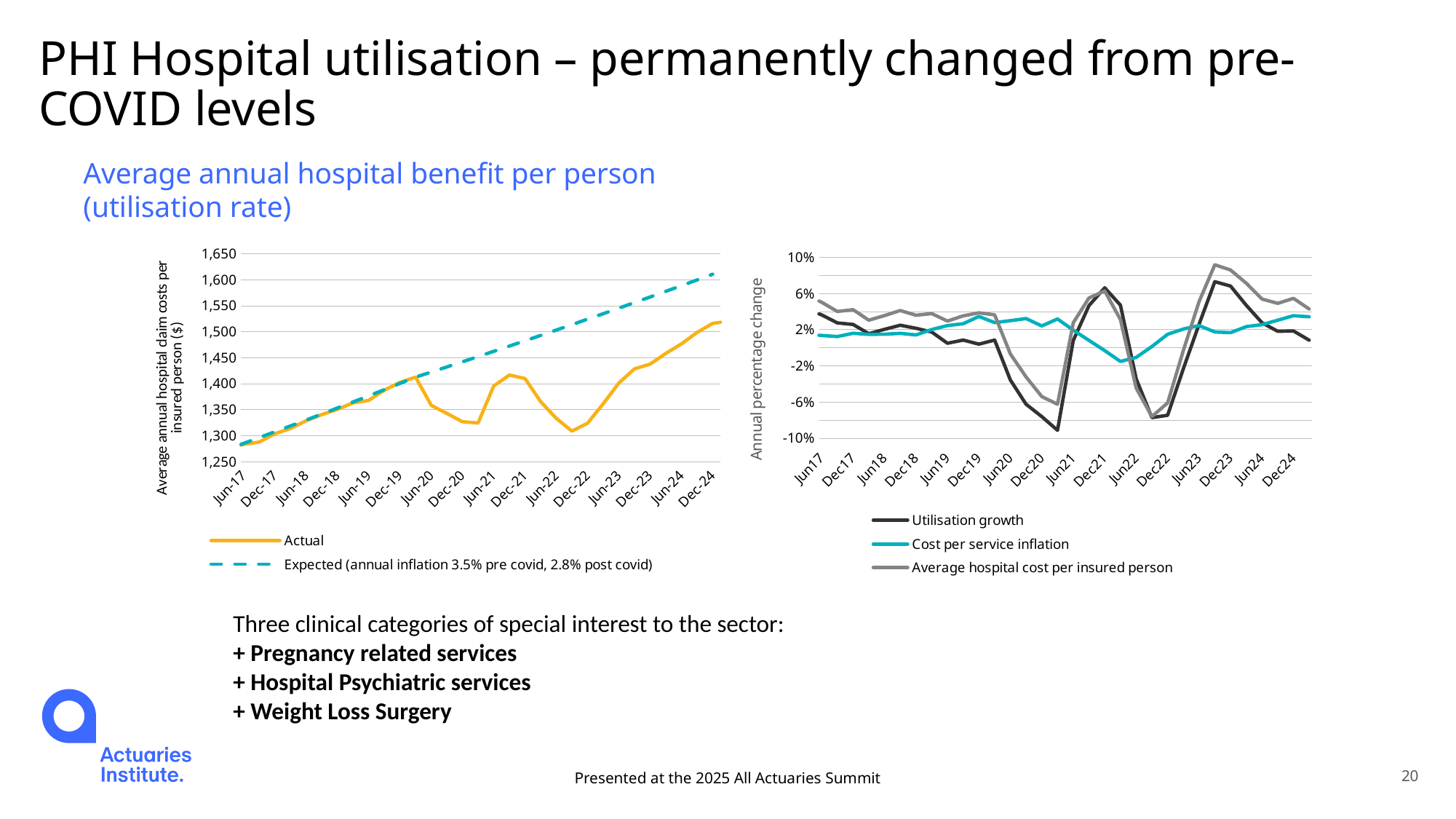
In the right chart, is the Utilisation growth value at Dec20 greater or less than -6%? less In the left chart, at Dec-24, which is higher: the Actual line or the Expected line? Expected In the left chart, is the Expected value at Dec-24 greater or less than 1,550? greater What type of chart is the left chart titled 'Average annual hospital benefit per person (utilisation rate)'? Line chart In the left chart, does the Expected (dashed) line rise or fall from Jun-17 to Dec-24? Rises In the left chart, is the Actual value at Dec-22 greater or less than 1,350? less In the left chart, what does the legend say the Expected line assumes for annual inflation pre covid and post covid? 3.5% pre covid, 2.8% post covid In the left chart, how many date labels are shown on the x axis? 16 In the right chart, at Dec20, which series is higher: Utilisation growth or Cost per service inflation? Cost per service inflation How many series does the legend of the right chart (Annual percentage change) list? 3 How many series does the legend of the left chart list? 2